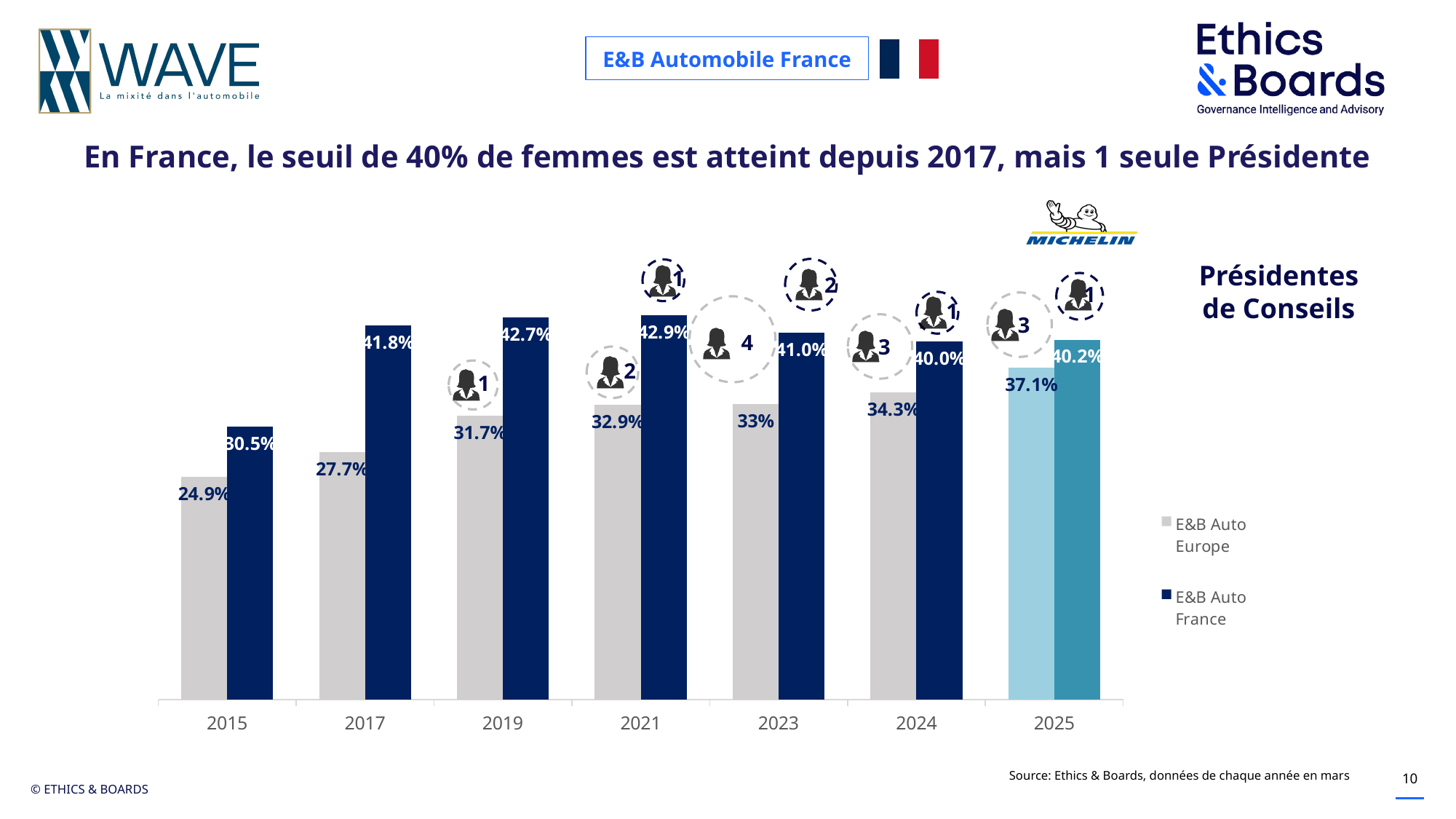
Which is larger in 2023: E&B Auto Europe or E&B Auto France? E&B Auto France What kind of chart is shown on the slide? Bar chart How many years are shown on the x axis? 7 What is the value for E&B Auto Europe in 2015? 24.9% Do the E&B Auto Europe values rise or fall from 2015 to 2025? Rise What is the difference between the E&B Auto France and E&B Auto Europe values in 2017? 14.1% In which year is the E&B Auto France value highest? 2021 What is the value for E&B Auto France in 2021? 42.9% What is the value for E&B Auto Europe in 2025? 37.1% How many series does the legend list? 2 What is the value for E&B Auto France in 2024? 40.0% In which year is the E&B Auto Europe value lowest? 2015